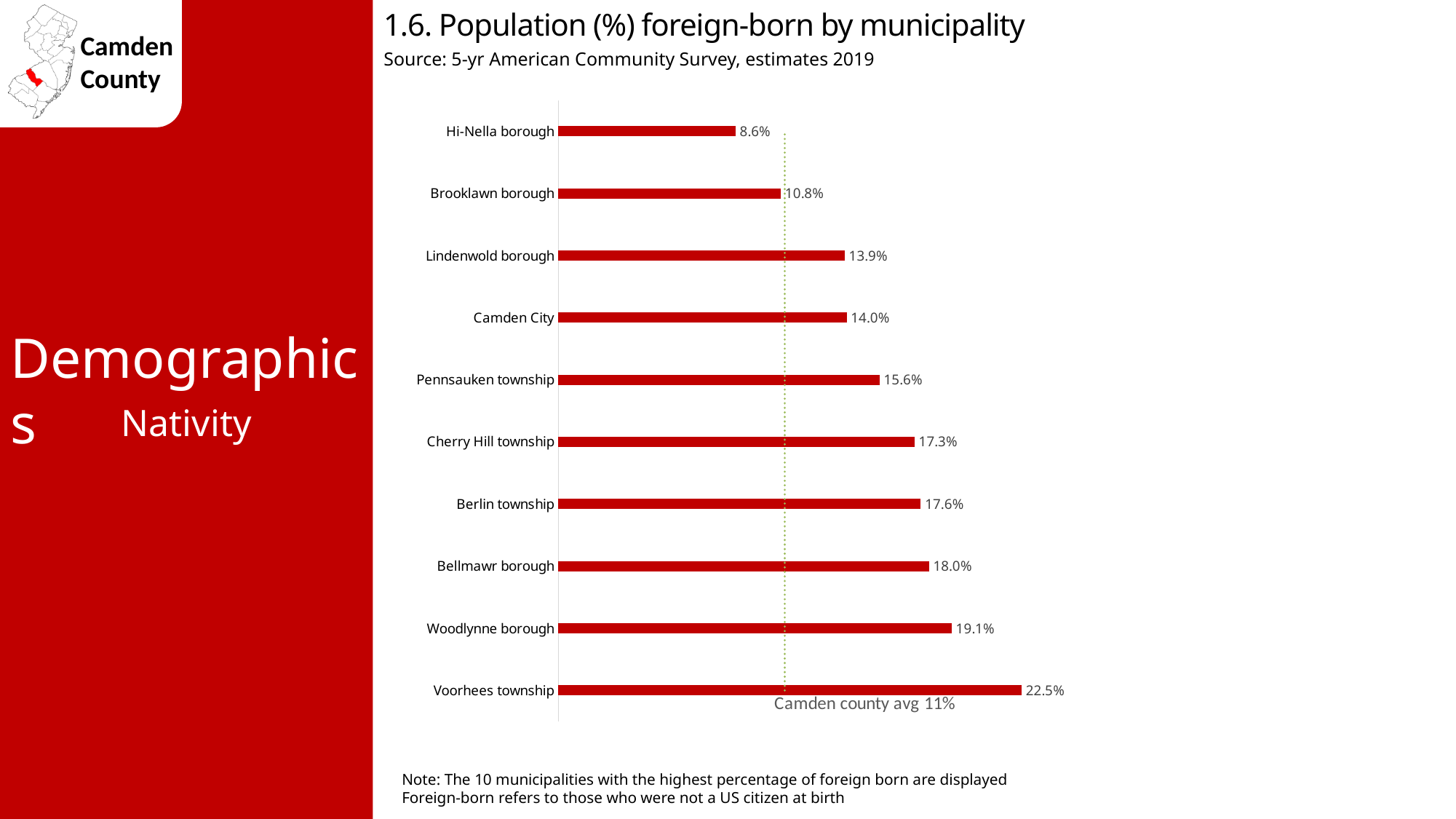
What is the foreign-born percentage shown for Camden City? 14.0% What is the source of the data shown in the chart? 5-yr American Community Survey, estimates 2019 What type of chart is used on this slide? Bar chart What is the Camden county average foreign-born percentage indicated by the dotted line? 11% Which municipality has the lowest foreign-born percentage on the chart? Hi-Nella borough Which municipality has the highest foreign-born percentage? Voorhees township What is the difference between the foreign-born percentages of Voorhees township and Woodlynne borough? 3.4% How many municipalities are shown on the chart? 10 What percentage of the population is foreign-born in Voorhees township? 22.5% Which has a higher foreign-born percentage, Cherry Hill township or Lindenwold borough? Cherry Hill township What is the difference between Bellmawr borough and Brooklawn borough? 7.2% What value is shown for Pennsauken township? 15.6%